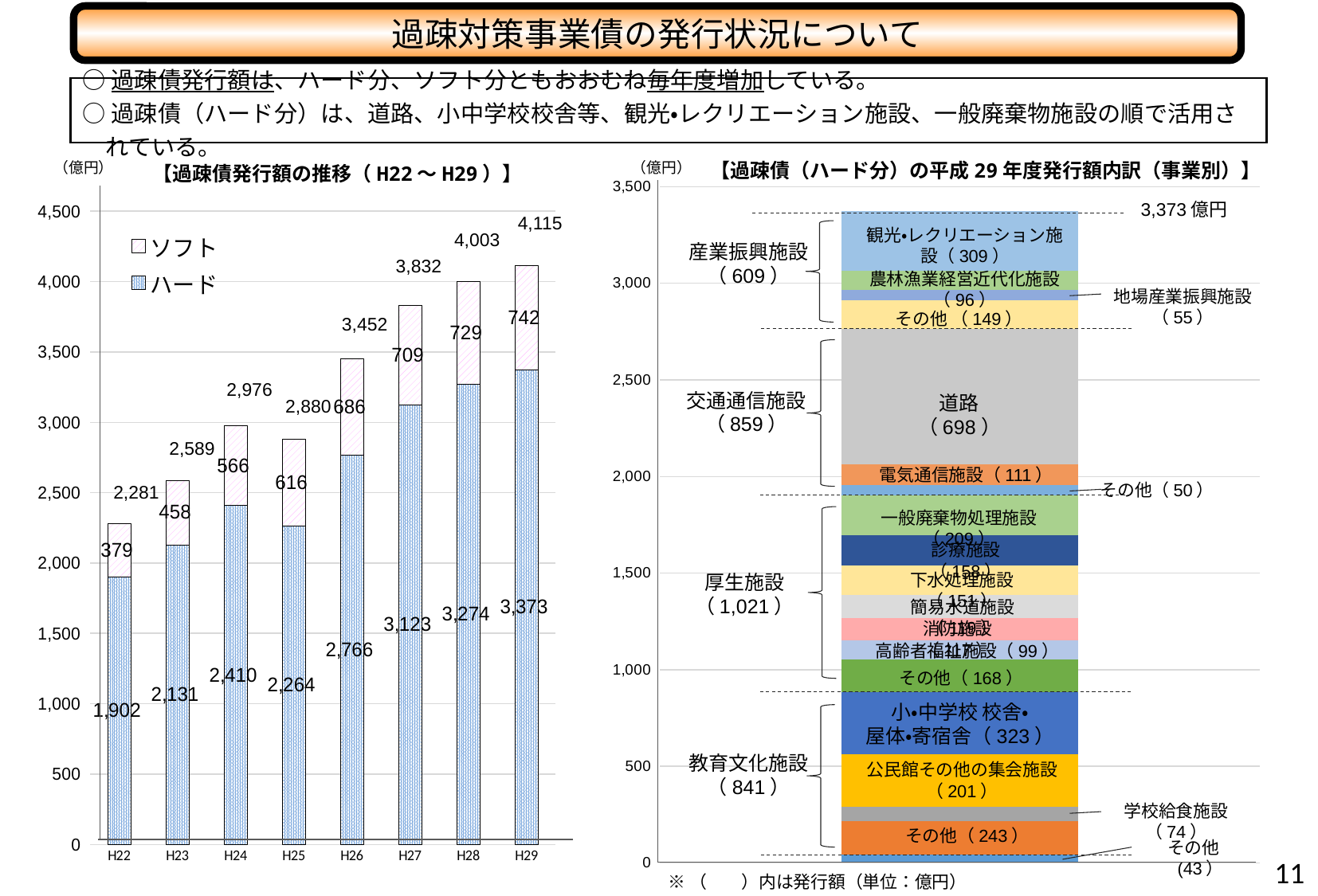
左のグラフ「過疎債発行額の推移（H22～H29）」で、H29のハード分の値はいくらですか。 3,373 左のグラフ「過疎債発行額の推移（H22～H29）」で、合計発行額が最も高い年度はどれですか。 H29 左のグラフ「過疎債発行額の推移（H22～H29）」で、H24とH25のハード分ではどちらが大きいですか。 H24 左のグラフ「過疎債発行額の推移（H22～H29）」で、H22のソフト分の値はいくらですか。 379 左のグラフ「過疎債発行額の推移（H22～H29）」はどの種類のグラフですか。 積み上げ棒グラフ 左のグラフ「過疎債発行額の推移（H22～H29）」の凡例には、いくつの系列がありますか。 2 右のグラフ「過疎債（ハード分）の平成29年度発行額内訳（事業別）」で、厚生施設の合計発行額はいくらですか。 1,021 左のグラフ「過疎債発行額の推移（H22～H29）」で、ハード分が最も低い年度はどれですか。 H22 右のグラフ「過疎債（ハード分）の平成29年度発行額内訳（事業別）」で、道路の発行額はいくらですか。 698 左のグラフ「過疎債発行額の推移（H22～H29）」には、いくつの年度が表示されていますか。 8 左のグラフ「過疎債発行額の推移（H22～H29）」で、H26の合計発行額はいくらですか。 3,452 左のグラフ「過疎債発行額の推移（H22～H29）」で、H28とH27の合計発行額の差はいくらですか。 171